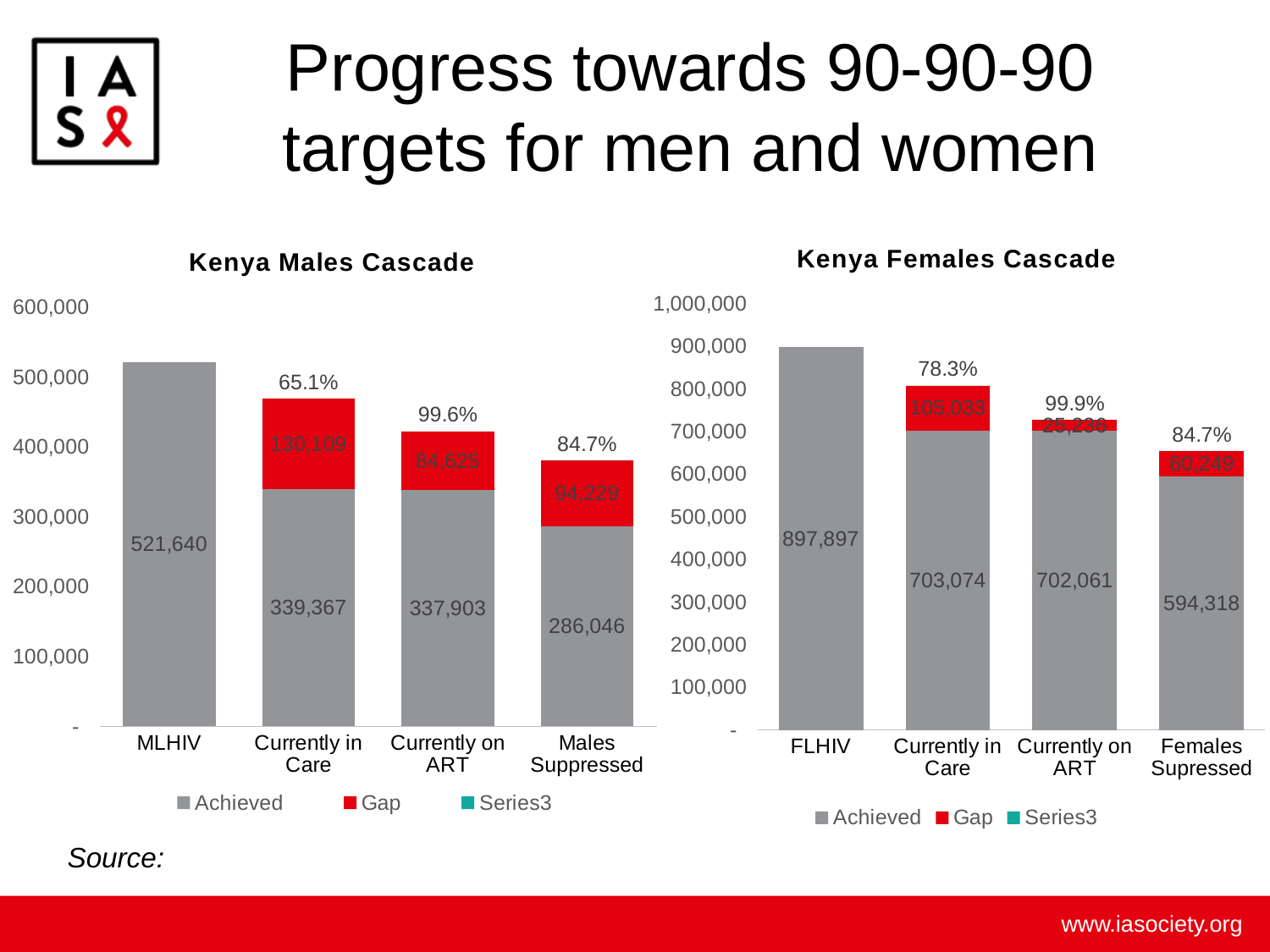
In the Kenya Females Cascade chart, which category has the highest Achieved value? FLHIV In the Kenya Females Cascade chart, what percentage is shown above the Females Supressed bar? 84.7% In the Kenya Females Cascade chart, what is the Achieved value for Currently on ART? 702,061 In the Kenya Females Cascade chart, is the Achieved value for Females Supressed greater or less than 500,000? greater In the Kenya Females Cascade chart, what is the total of the Currently in Care stacked bar (Achieved plus Gap)? 808,107 How many categories are shown on the x axis of the Kenya Males Cascade chart? 4 In the Kenya Males Cascade chart, which category has the lowest Achieved value? Males Suppressed In the Kenya Males Cascade chart, what is the total height of the Males Suppressed stacked bar (Achieved plus Gap)? 380,275 How many series does the legend of the Kenya Females Cascade chart list? 3 In the Kenya Males Cascade chart, what is the Achieved value for MLHIV? 521,640 In the Kenya Males Cascade chart, what is the Gap value for Currently in Care? 130,109 In the Kenya Males Cascade chart, what is the difference between the Achieved values for MLHIV and Currently in Care? 182,273